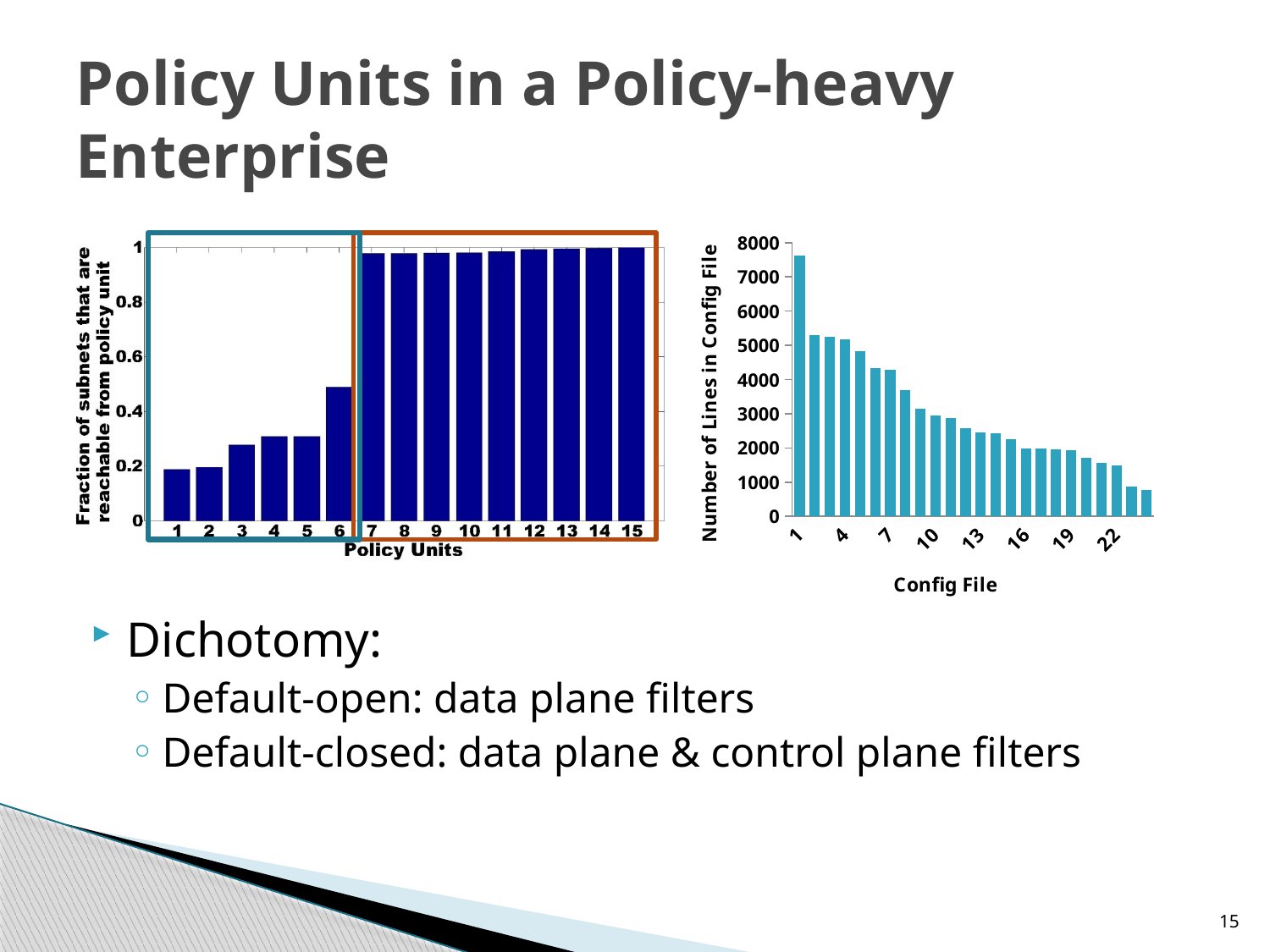
In the left chart, which has the larger value, policy unit 3 or policy unit 6? policy unit 6 In the right chart, 'Number of Lines in Config File', which config file has the highest number of lines? 1 In the right chart, do the values rise or fall as the config file number increases? fall In the left chart, is the value for policy unit 10 greater or less than 0.8? greater In the right chart, is the value for config file 22 greater or less than 2000? less In the left chart, is the value for policy unit 6 greater or less than 0.6? less In the left chart, how many policy units are plotted on the x axis? 15 In the left chart, do the values generally rise or fall as the policy unit number increases? rise What kind of chart is the left chart, 'Fraction of subnets that are reachable from policy unit'? bar chart